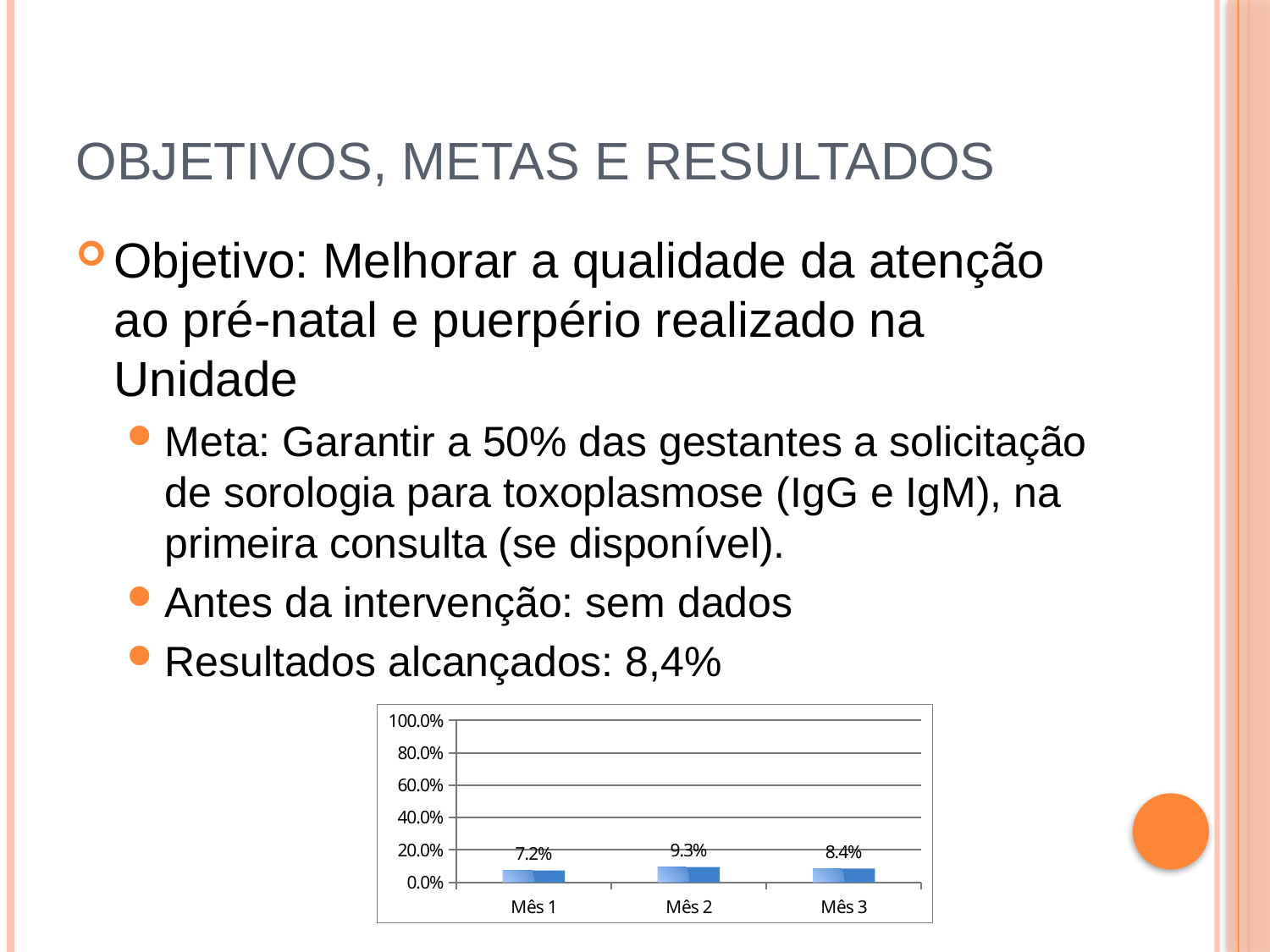
What kind of chart is shown on the slide? bar chart How many categories are shown on the x axis of the chart? 3 What is the value for Mês 2? 9.3% Is the value for Mês 2 greater or less than 20.0%? less What is the difference between the values for Mês 2 and Mês 1? 2.1% What is the difference between the values for Mês 2 and Mês 3? 0.9% Which month has the lowest value? Mês 1 What is the highest value shown on the chart's y axis? 100.0% What is the value for Mês 1? 7.2% What is the value for Mês 3? 8.4% Which month has the highest value? Mês 2 Which is larger, the value for Mês 3 or the value for Mês 1? Mês 3